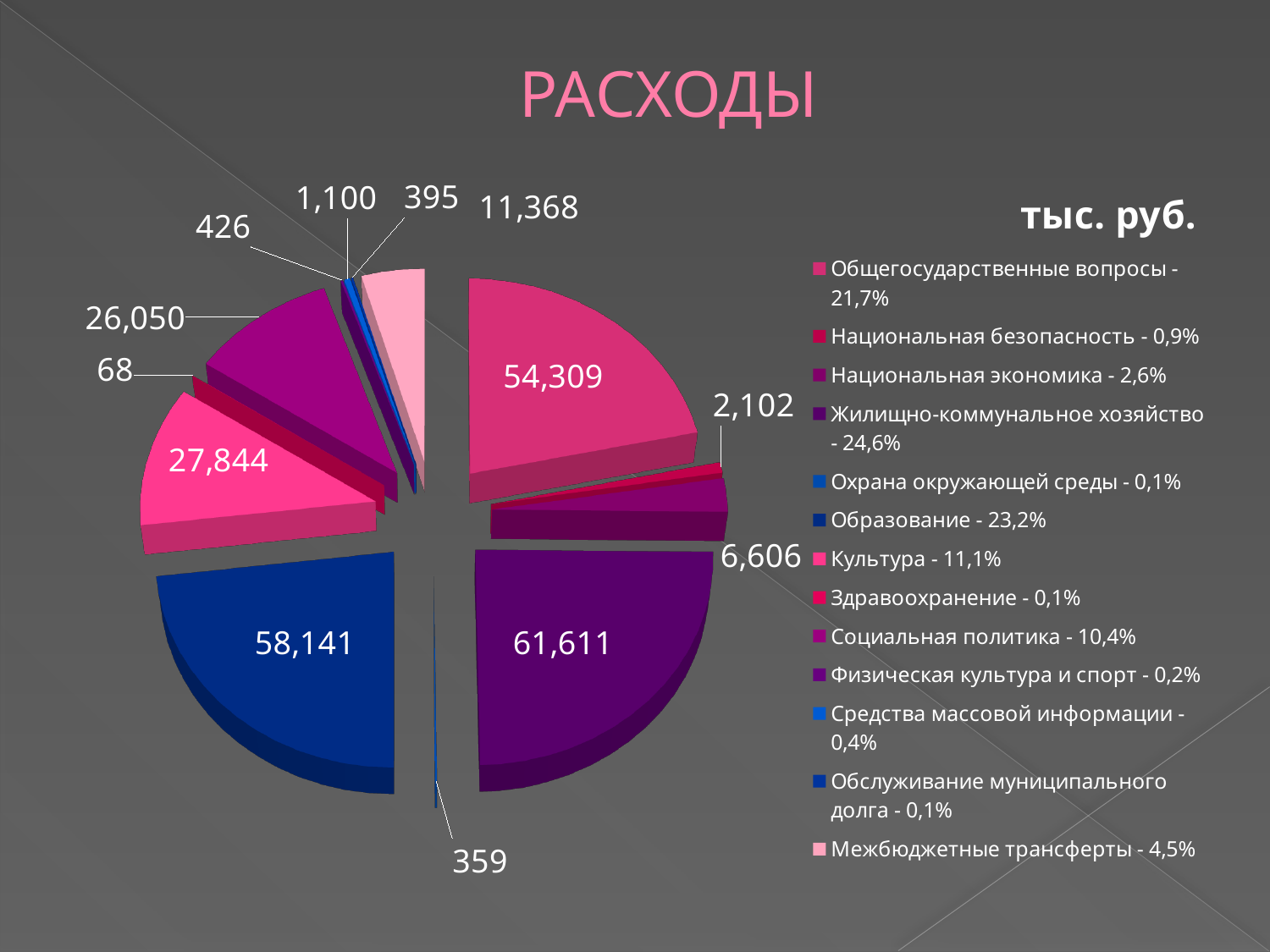
What kind of chart is shown on the slide? pie chart Which category has the smallest slice of the pie? Здравоохранение How many categories does the pie chart have? 13 Which is larger, the Общегосударственные вопросы slice or the Социальная политика slice? Общегосударственные вопросы What is the difference between the Жилищно-коммунальное хозяйство value and the Образование value? 3,470 What is the value of the Межбюджетные трансферты slice? 11,368 What is the value of the Жилищно-коммунальное хозяйство slice? 61,611 Which category has the largest slice of the pie? Жилищно-коммунальное хозяйство What is the title of the chart? тыс. руб. What is the value of the Культура slice? 27,844 What share of the pie does Образование represent, according to the legend? 23,2% What is the value of the Образование slice? 58,141